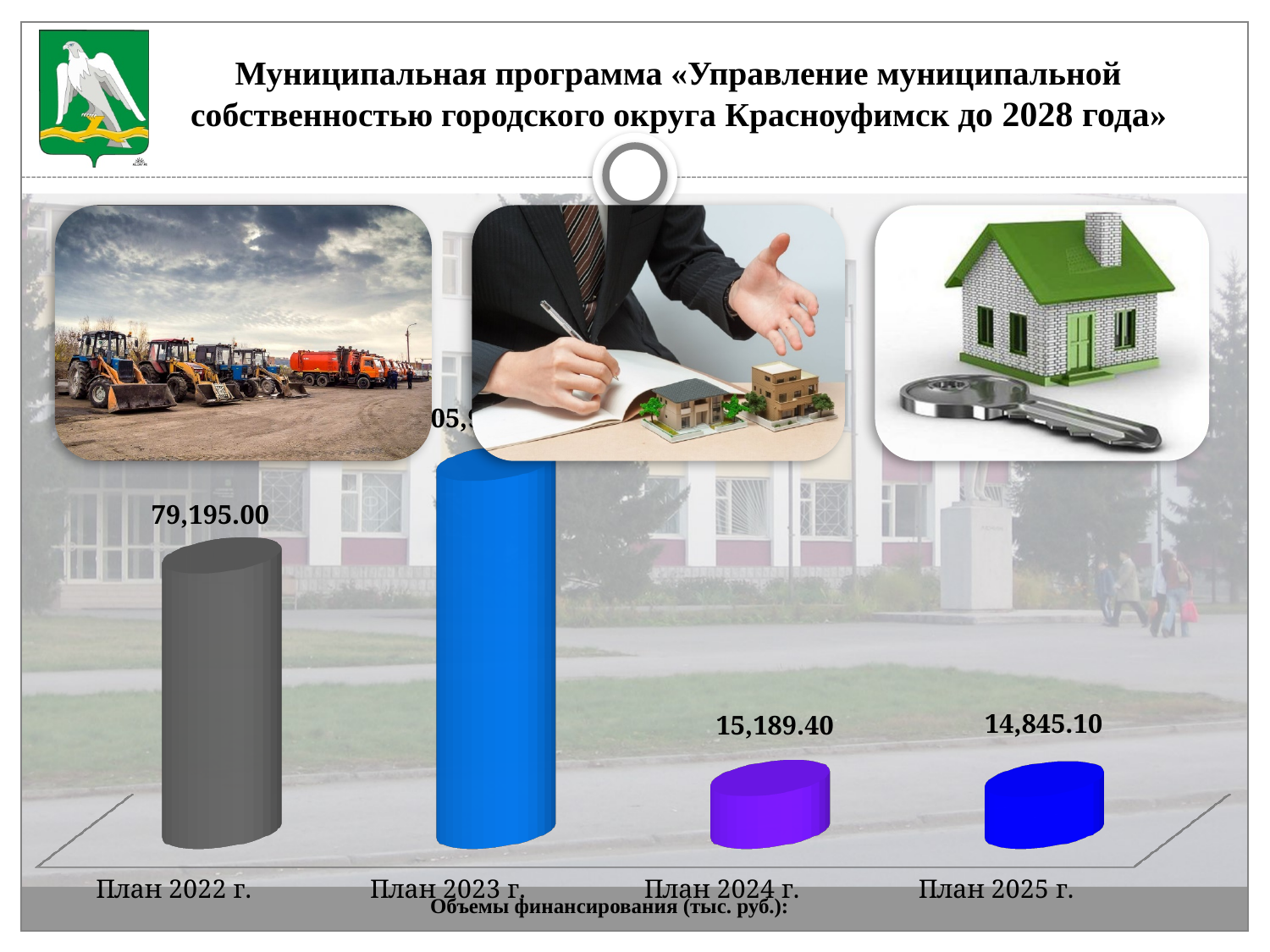
How many categories are shown in the chart? 4 Which category has the lowest value? План 2025 г. Which is larger, the value for План 2022 г. or the value for План 2024 г.? План 2022 г. What is the value for План 2024 г.? 15,189.40 What is the difference between the values for План 2024 г. and План 2025 г.? 344.30 Do the values rise or fall from План 2023 г. to План 2025 г.? Fall What is the value for План 2022 г.? 79,195.00 Which is larger, the value for План 2023 г. or the value for План 2022 г.? План 2023 г. What is the difference between the values for План 2022 г. and План 2024 г.? 64,005.60 Which category has the highest value? План 2023 г. What kind of chart is shown on the slide? Bar chart What is the value for План 2025 г.? 14,845.10